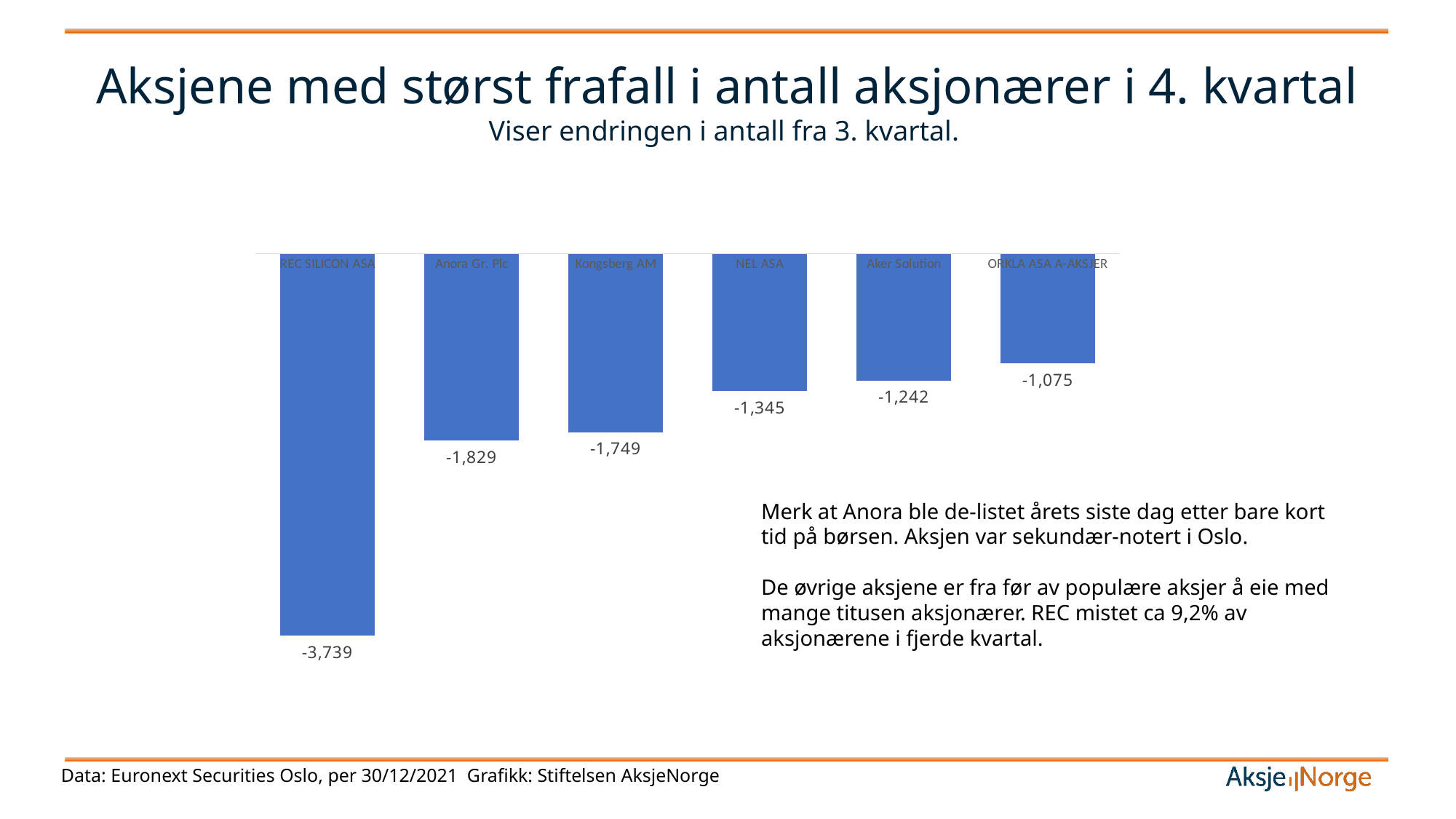
What is the value shown for NEL ASA? -1,345 What is the value shown for Aker Solution? -1,242 What kind of chart is shown on the slide? Bar chart Which category has the largest decline (the lowest value) in the chart? REC SILICON ASA What is the value shown for REC SILICON ASA? -3,739 What is the difference between the values for REC SILICON ASA and Anora Gr. Plc? 1,910 What is the value shown for Kongsberg AM? -1,749 What is the value shown for Anora Gr. Plc? -1,829 How many categories are shown in the chart? 6 Which category has the smallest decline (the highest value) in the chart? ORKLA ASA A-AKSJER What is the value shown for ORKLA ASA A-AKSJER? -1,075 Which has a larger decline, NEL ASA or Aker Solution? NEL ASA